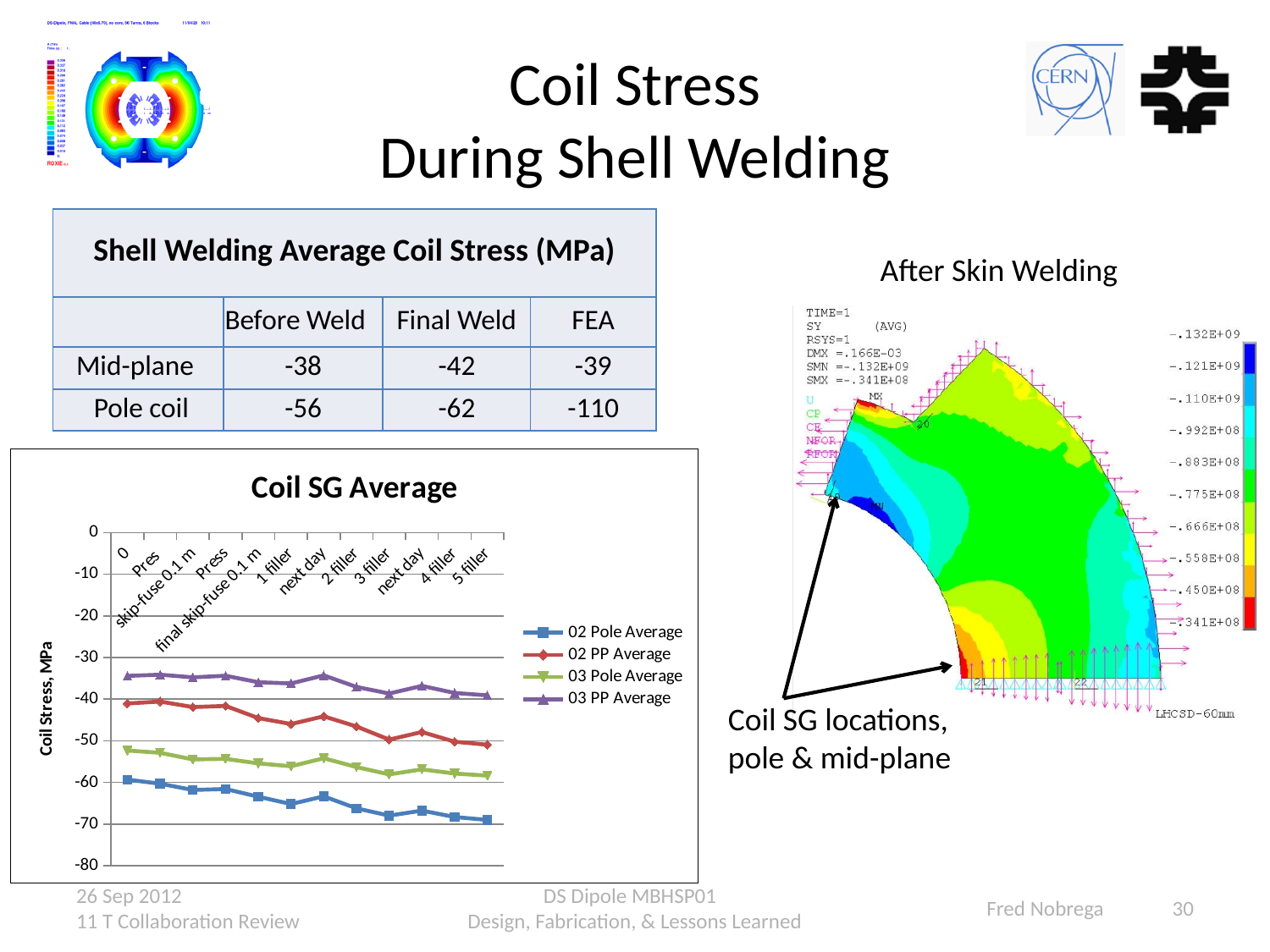
In the "Coil SG Average" chart, which series has the highest (least negative) values across the x axis? 03 PP Average What is the y-axis label of the "Coil SG Average" chart? Coil Stress, MPa In the "Coil SG Average" chart, is the 02 Pole Average value at "5 filler" greater or less than -60? less What kind of chart is the "Coil SG Average" chart? line chart In the "Coil SG Average" chart, do the values of the 02 Pole Average series rise or fall from left to right along the x axis? fall How many points along the x axis does each series in the "Coil SG Average" chart have? 12 In the "Coil SG Average" chart, is the 03 PP Average value at "0" greater or less than -40? greater In the "Coil SG Average" chart, is the 03 Pole Average value at "0" greater or less than -50? less What is the title of the line chart on the slide? Coil SG Average In the "Coil SG Average" chart, which series has the lowest (most negative) values across the x axis? 02 Pole Average How many series does the legend of the "Coil SG Average" chart list? 4 In the "Coil SG Average" chart, which is larger at "5 filler": the 03 PP Average value or the 02 Pole Average value? 03 PP Average